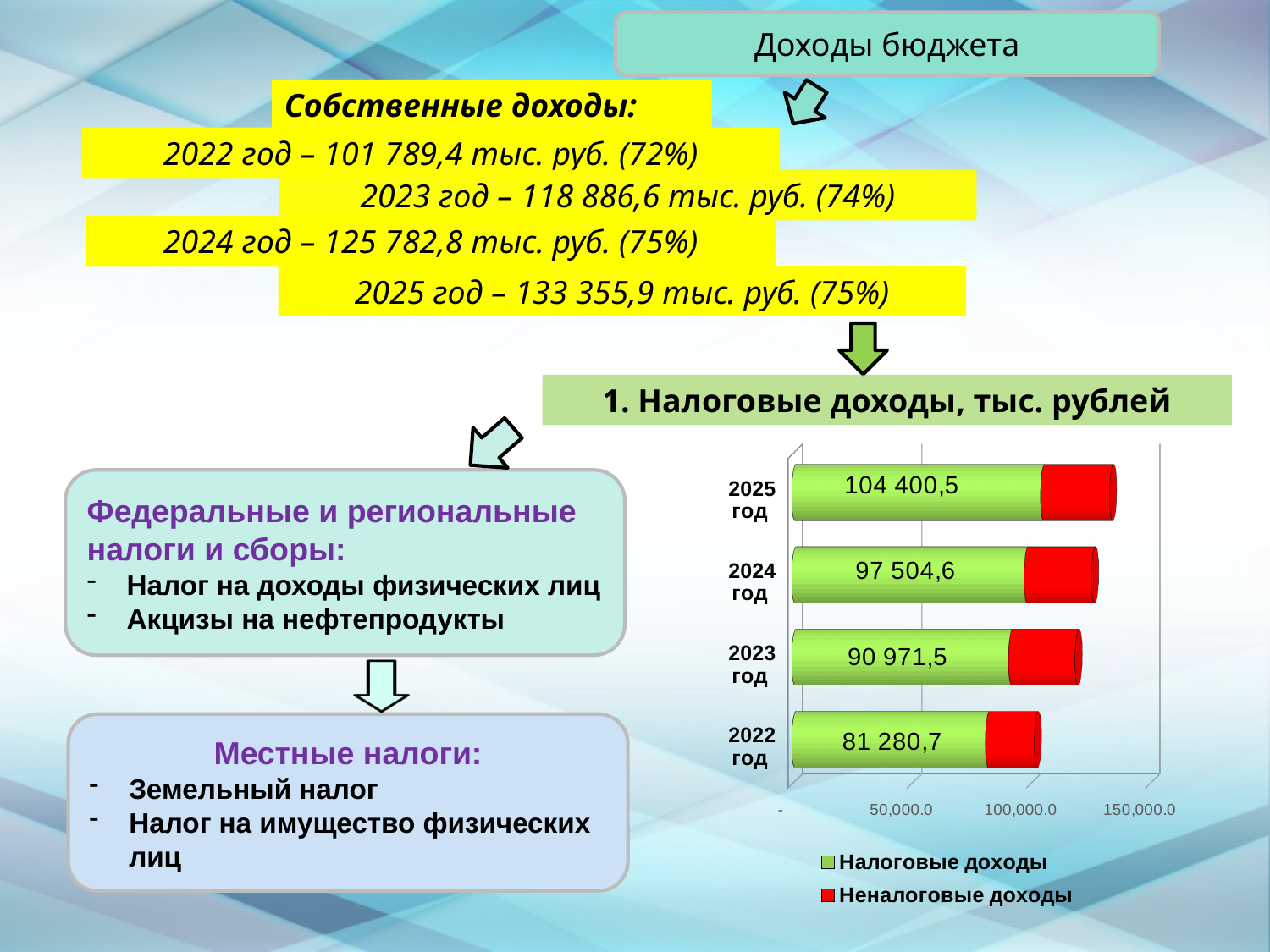
What is the value of Налоговые доходы for 2025 год? 104 400,5 What is the difference in Налоговые доходы between 2025 год and 2022 год? 23 119,8 What type of chart is shown on the slide? bar chart What is the value of Налоговые доходы for 2023 год? 90 971,5 Which year has the highest value of Налоговые доходы? 2025 год How many years (categories) are shown in the chart? 4 What is the value of Налоговые доходы for 2024 год? 97 504,6 What is the value of Налоговые доходы for 2022 год? 81 280,7 Which is larger: Налоговые доходы for 2024 год or for 2023 год? 2024 год How many series does the legend list? 2 Is the total of the stacked bar for 2025 год greater or less than 100,000.0? greater Which year has the lowest value of Налоговые доходы? 2022 год